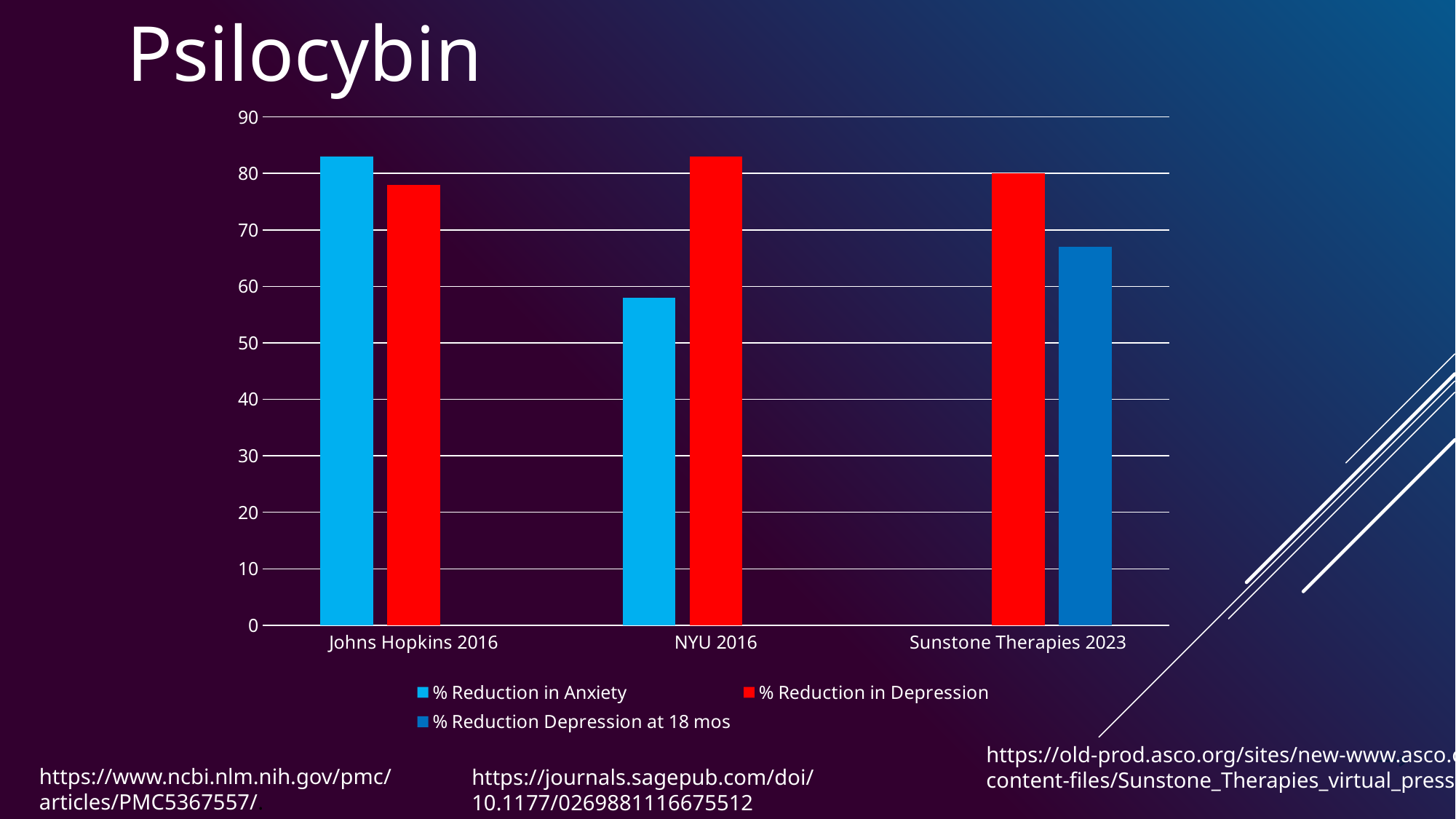
How many categories are shown on the x axis of the chart? 3 Which category is the only one with a bar for % Reduction Depression at 18 mos? Sunstone Therapies 2023 Which is larger for NYU 2016: % Reduction in Anxiety or % Reduction in Depression? % Reduction in Depression Which is larger for Johns Hopkins 2016: % Reduction in Anxiety or % Reduction in Depression? % Reduction in Anxiety What is the title of the slide containing the chart? Psilocybin What kind of chart is shown on the slide? bar chart Is the value for % Reduction in Anxiety for NYU 2016 greater or less than 60? less How many series does the chart's legend list? 3 Is the value for % Reduction in Depression for NYU 2016 greater or less than 80? greater Is the value for % Reduction Depression at 18 mos for Sunstone Therapies 2023 greater or less than 70? less Which category has the lowest value for % Reduction in Anxiety? NYU 2016